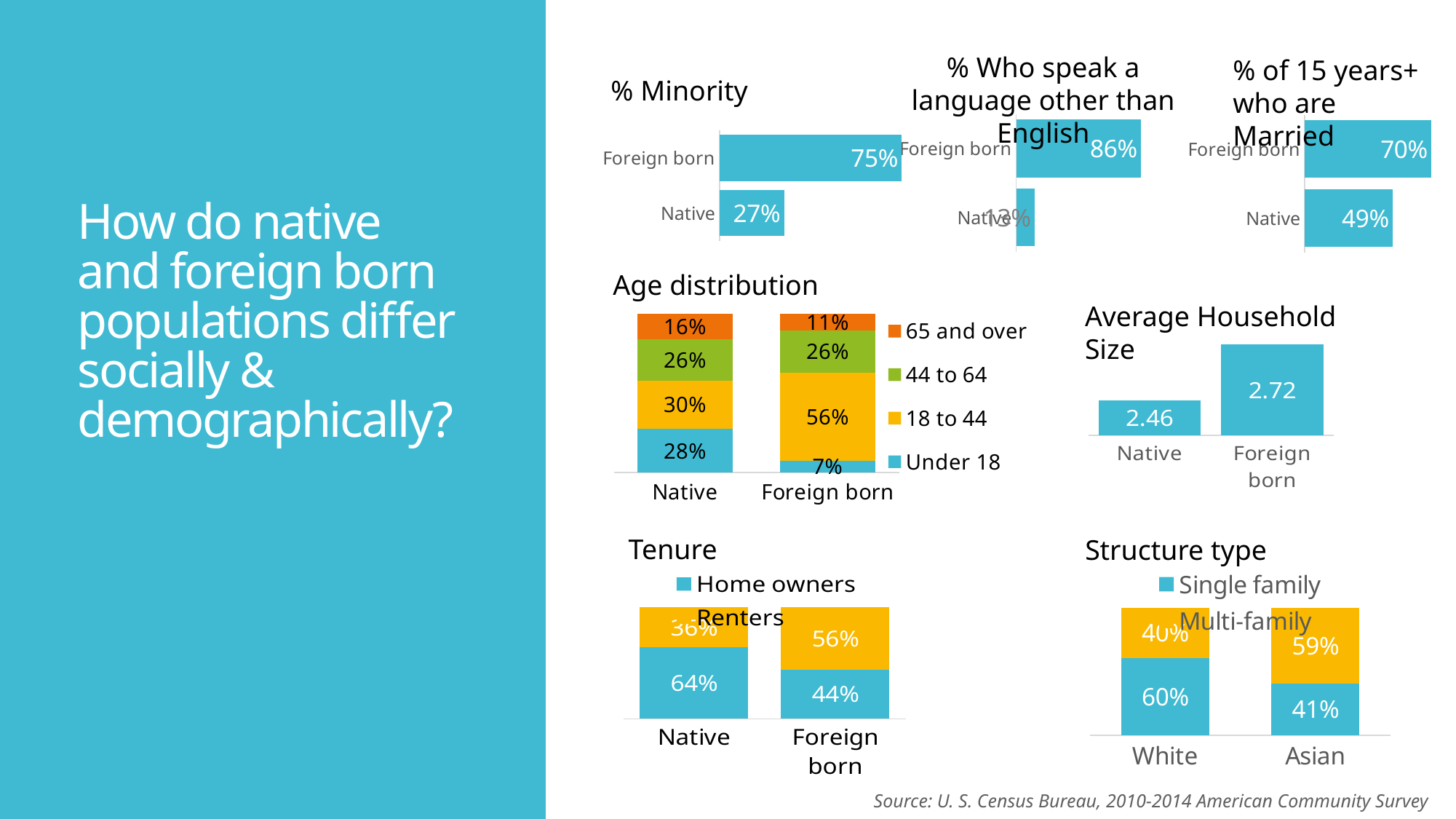
In the % of 15 years+ who are Married chart, which category has the higher value, Foreign born or Native? Foreign born In the Average Household Size chart, which category has the lower value? Native In the Structure type chart, what percentage of Asian households are Single family? 41% In the Tenure chart, what percentage of Foreign born are Home owners? 44% In the % Minority chart, what is the value for Foreign born? 75% In the Average Household Size chart, what is the value for Foreign born? 2.72 In the Age distribution chart, what share of the Foreign born population is 18 to 44? 56% In the % of 15 years+ who are Married chart, what is the value for Native? 49% In the % Who speak a language other than English chart, what is the value for Foreign born? 86% In the Age distribution chart, what share of the Native population is Under 18? 28% In the % Minority chart, what is the difference between the Foreign born and Native values? 48% How many series does the legend of the Age distribution chart list? 4